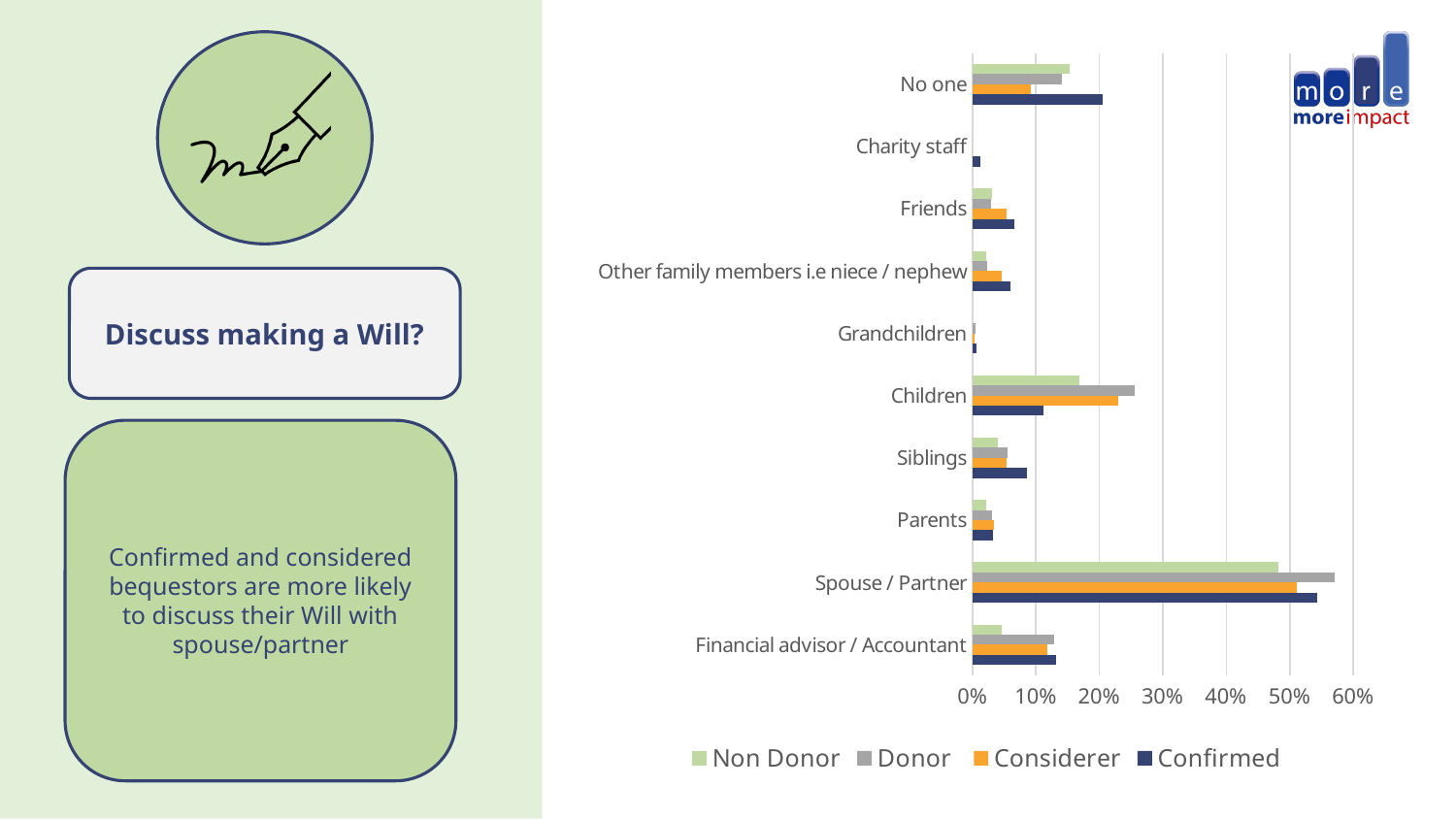
Is the Non Donor value for Spouse / Partner greater or less than 50%? less Is the Donor value for Children greater or less than 20%? greater Which category has the highest value for the Confirmed series? Spouse / Partner How many categories are shown on the chart's vertical axis? 10 What kind of chart is shown on the slide? bar chart Which series is listed last in the chart's legend? Confirmed How many series does the chart's legend list? 4 Which category has the highest value for the Non Donor series? Spouse / Partner Is the Non Donor value for Financial advisor / Accountant greater or less than 10%? less For the Children category, which is larger: the Donor value or the Confirmed value? Donor For the No one category, which is larger: the Confirmed value or the Non Donor value? Confirmed